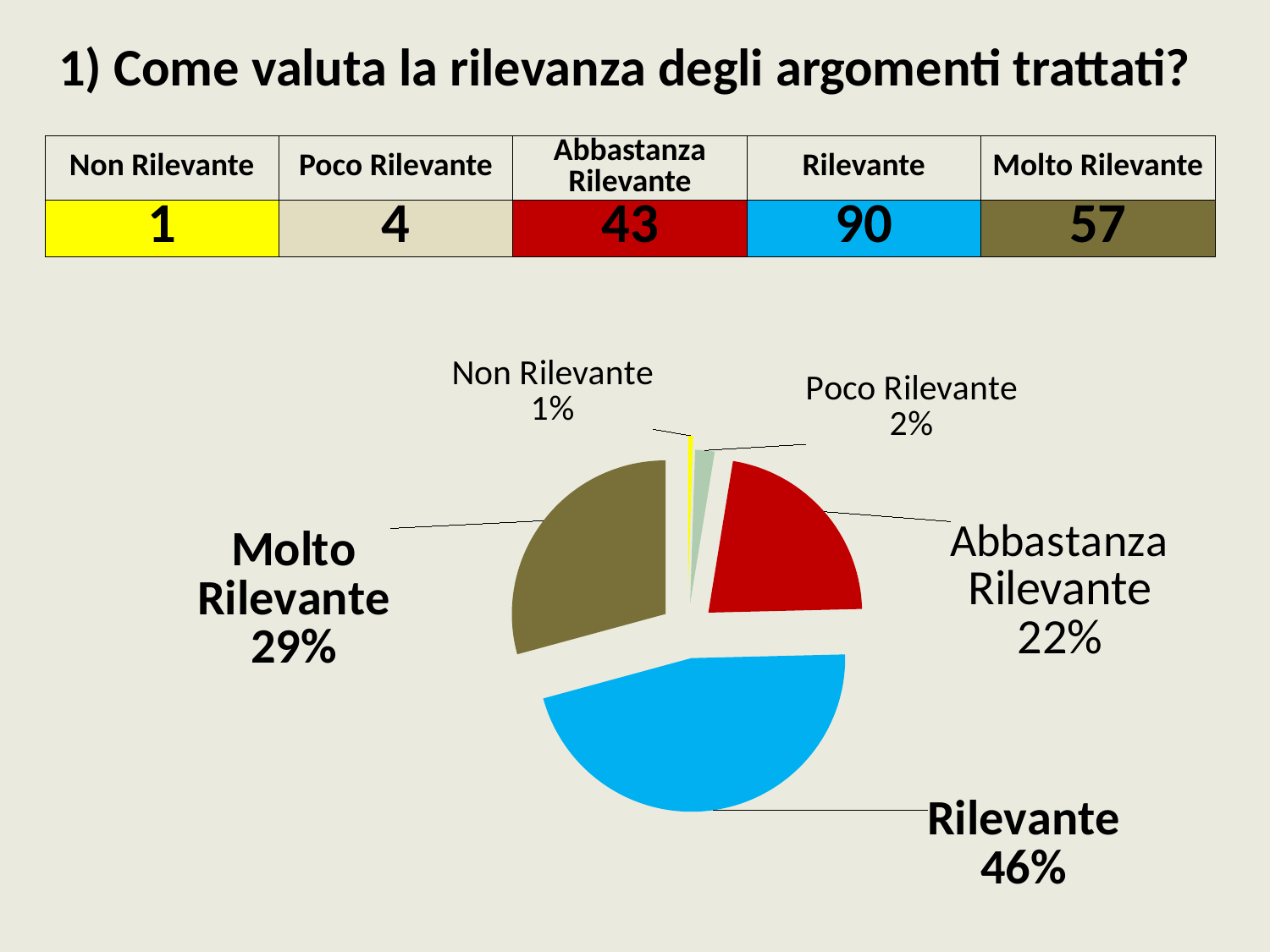
What kind of chart is shown on the slide? Pie chart Which category has the smallest slice of the pie? Non Rilevante What share of the pie does the Rilevante slice represent? 46% What share of the pie does the Abbastanza Rilevante slice represent? 22% What colour is the Rilevante slice of the pie? Blue Which category has the largest slice of the pie? Rilevante What is the title of the slide containing the chart? 1) Come valuta la rilevanza degli argomenti trattati? What is the difference in percentage points between the Rilevante and Molto Rilevante slices? 17% What share of the pie does the Molto Rilevante slice represent? 29% Which slice is larger, Molto Rilevante or Abbastanza Rilevante? Molto Rilevante How many slices does the pie chart have? 5